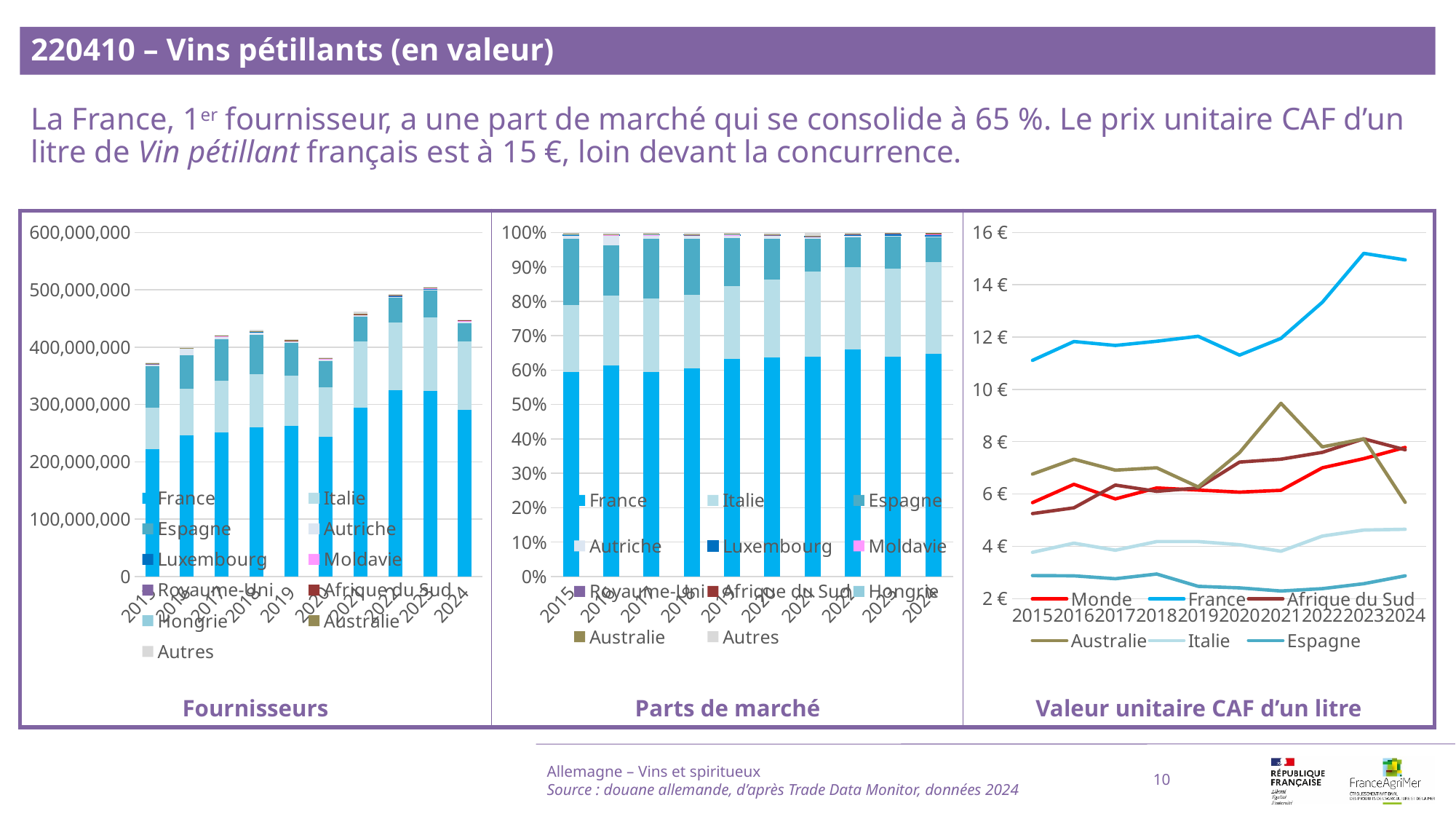
In the 'Valeur unitaire CAF d'un litre' chart, does the France line rise or fall between 2021 and 2023? rise In the 'Valeur unitaire CAF d'un litre' chart, is the value for France in 2024 greater or less than 14 €? greater In the 'Fournisseurs' chart, how many years are shown on the x axis? 10 In the 'Valeur unitaire CAF d'un litre' chart, which series has the highest value in 2024? France In the 'Valeur unitaire CAF d'un litre' chart, is the value for Australie in 2021 greater or less than 8 €? greater In the 'Valeur unitaire CAF d'un litre' chart, which series has the lowest value in 2024? Espagne How many series does the legend of the 'Parts de marché' chart list? 11 What kind of chart is the 'Valeur unitaire CAF d'un litre' chart? line chart In the 'Fournisseurs' chart, is the total of the 2020 bar greater or less than 400,000,000? less In the 'Fournisseurs' chart, which bar is taller, 2023 or 2020? 2023 How many series does the legend of the 'Valeur unitaire CAF d'un litre' chart list? 6 What kind of chart is the 'Fournisseurs' chart? bar chart